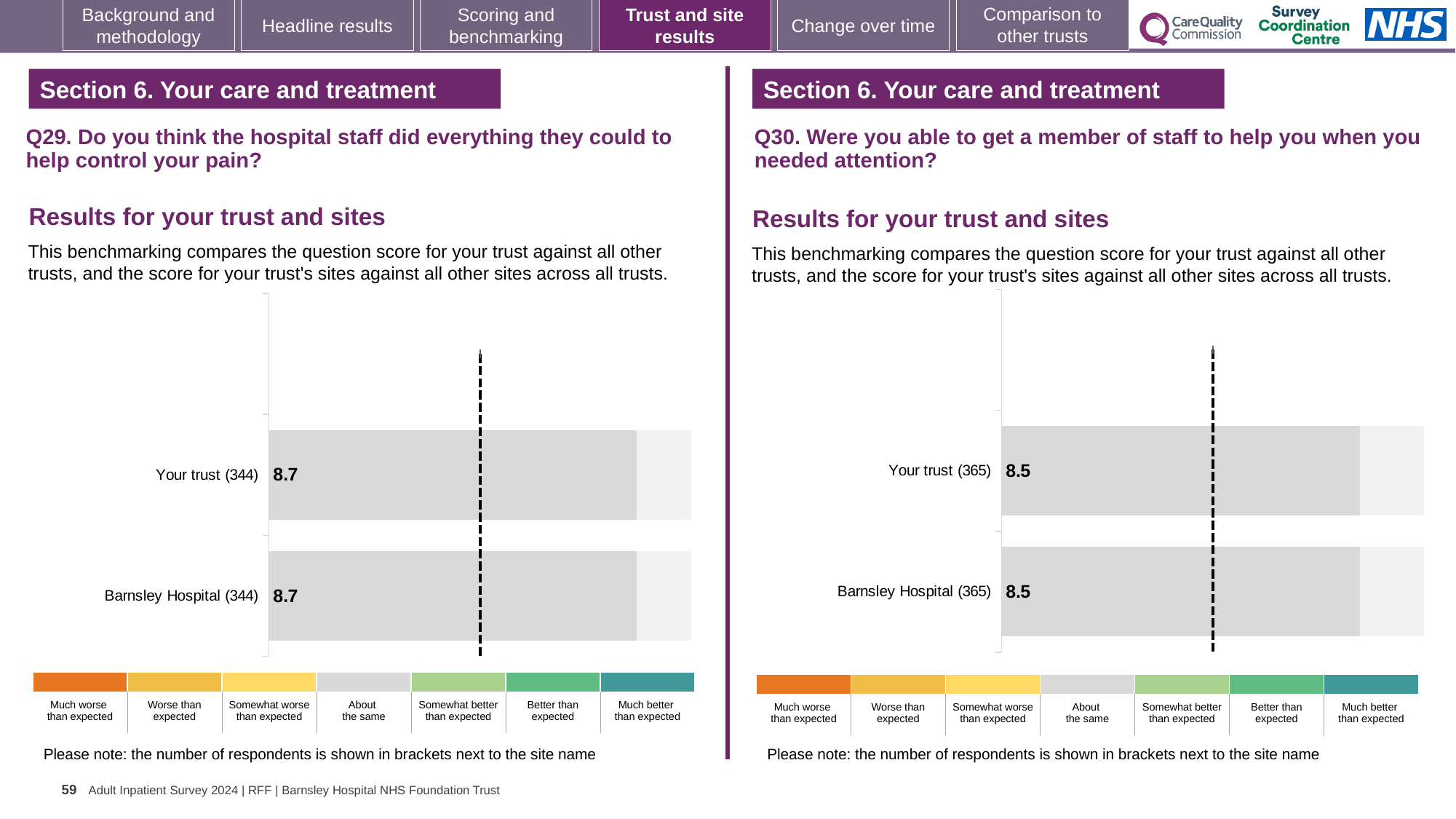
What kind of chart is used for the Q29 results on the left? Bar chart In the Q29 chart on the left, how many respondents are shown in brackets next to Your trust? 344 How many bars are plotted in the Q30 chart on the right? 2 In the Q30 chart on the right, what is the score for Barnsley Hospital? 8.5 In the Q30 chart on the right, what is the score for Your trust? 8.5 In the Q30 chart on the right, which benchmark category does the grey colour of the bars correspond to in the legend? About the same In the Q30 chart on the right, what is the difference between the Your trust score and the Barnsley Hospital score? 0 In the Q29 chart on the left, what is the score for Your trust? 8.7 In the Q29 chart on the left, what is the difference between the Your trust score and the Barnsley Hospital score? 0 How many bars are plotted in the Q29 chart on the left? 2 In the Q29 chart on the left, what is the score for Barnsley Hospital? 8.7 In the Q30 chart on the right, how many respondents are shown in brackets next to Barnsley Hospital? 365